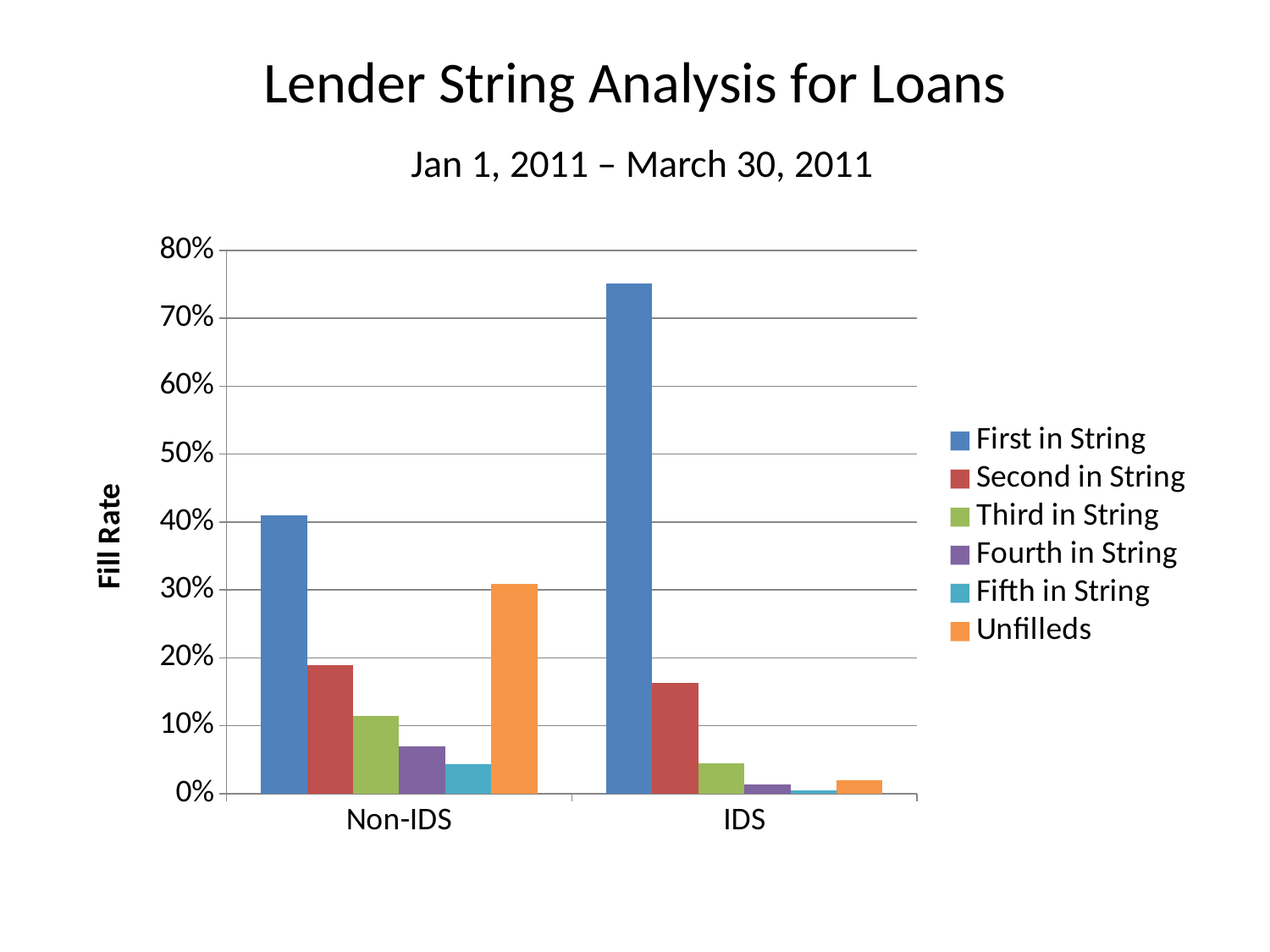
Is the value for Unfilleds in the Non-IDS category greater or less than 20%? greater How many series does the legend list? 6 What is the label on the vertical axis? Fill Rate Is the value for Second in String in the IDS category greater or less than 20%? less What kind of chart is shown on the slide? bar chart Which is larger: First in String for IDS or First in String for Non-IDS? First in String for IDS Which series has the lowest value in the IDS category? Fifth in String How many categories are shown on the x axis? 2 Is the value for First in String in the IDS category greater or less than 70%? greater Which is larger: Unfilleds for Non-IDS or Unfilleds for IDS? Unfilleds for Non-IDS Which series has the highest value in the IDS category? First in String Which series has the lowest value in the Non-IDS category? Fifth in String